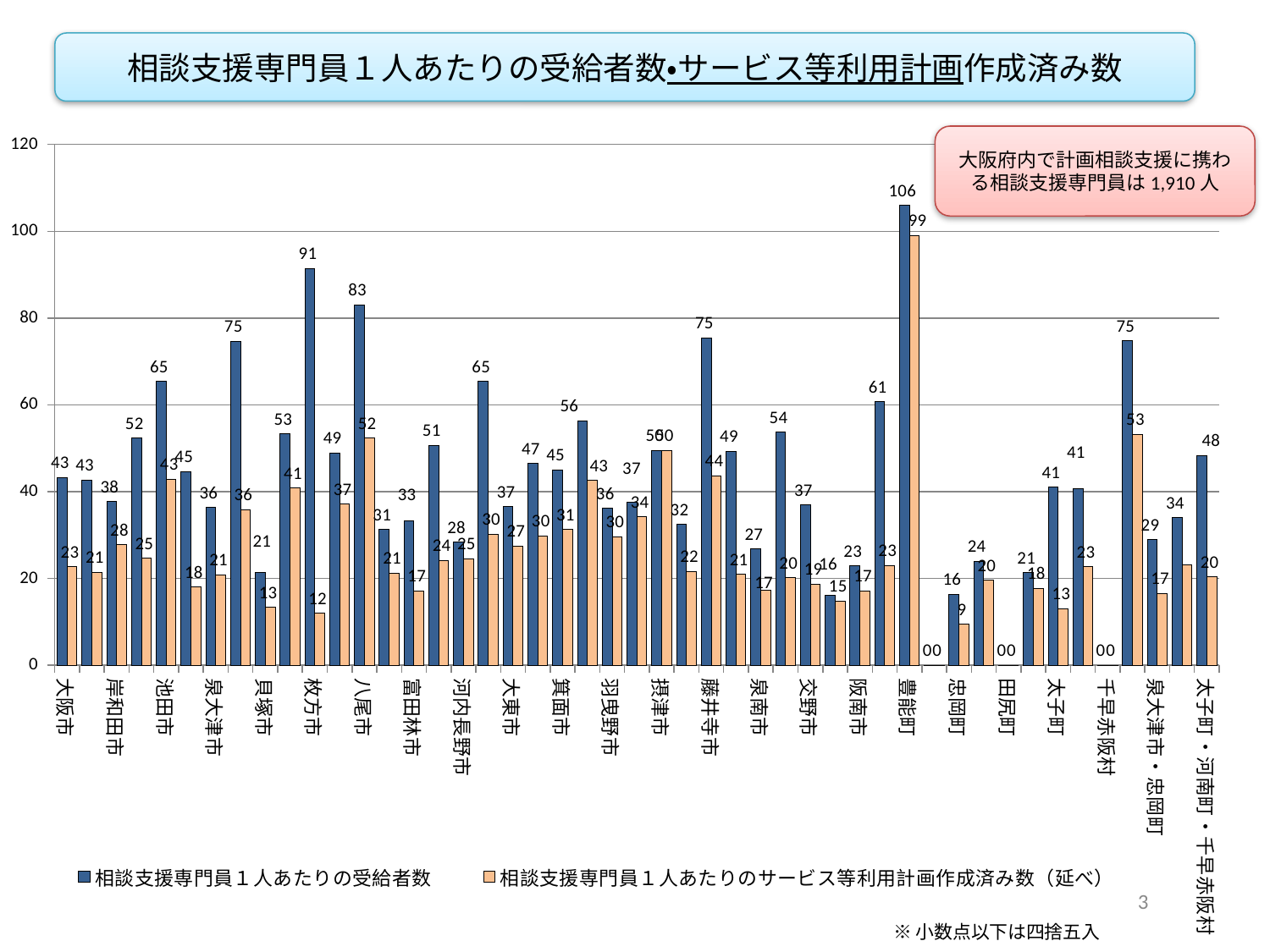
What is the value of 相談支援専門員１人あたりの受給者数 for 大阪市? 43 Which category has the highest value for 相談支援専門員１人あたりの受給者数? 豊能町 According to the text box on the slide, how many 相談支援専門員 are engaged in 計画相談支援 in 大阪府? 1,910 人 What is the value of 相談支援専門員１人あたりの受給者数 for 枚方市? 91 Is the value of 相談支援専門員１人あたりの受給者数 for 八尾市 greater or less than 80? greater What is the value of 相談支援専門員１人あたりのサービス等利用計画作成済み数（延べ） for 豊能町? 99 What is the value of 相談支援専門員１人あたりのサービス等利用計画作成済み数（延べ） for 大阪市? 23 What kind of chart is shown on the slide? bar chart How many series does the legend list? 2 Which has the larger value for 相談支援専門員１人あたりの受給者数, 枚方市 or 八尾市? 枚方市 What is the difference between 相談支援専門員１人あたりの受給者数 and 相談支援専門員１人あたりのサービス等利用計画作成済み数（延べ） for 豊能町? 7 What is the value of 相談支援専門員１人あたりの受給者数 for 豊能町? 106